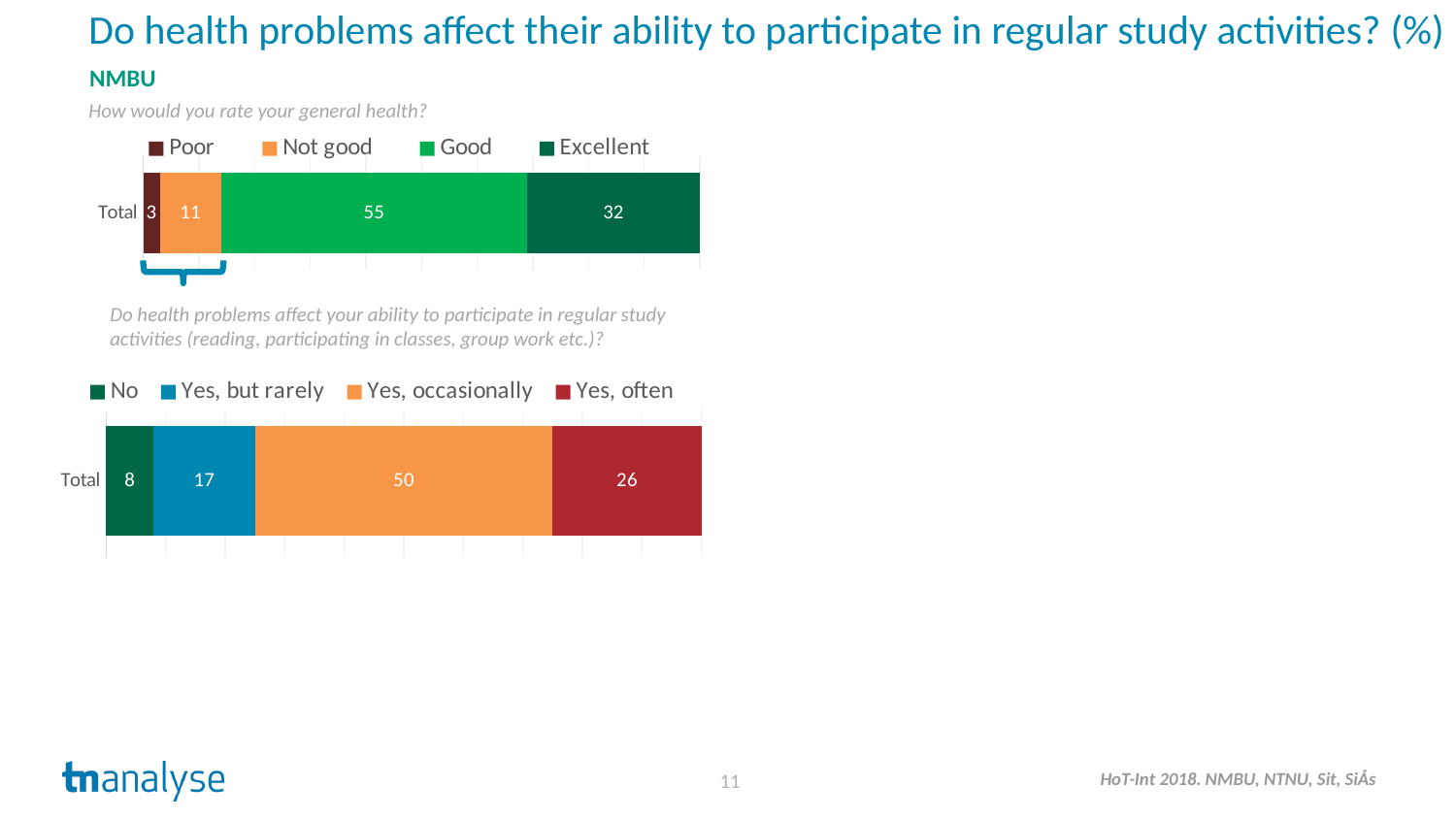
In the top chart ('How would you rate your general health?'), what is the difference between 'Good' and 'Excellent'? 23 In the bottom chart ('Do health problems affect your ability to participate in regular study activities'), which category has the lowest value? No In the top chart ('How would you rate your general health?'), what is the value for 'Poor'? 3 In the bottom chart ('Do health problems affect your ability to participate in regular study activities'), what is the value for 'Yes, often'? 26 In the bottom chart ('Do health problems affect your ability to participate in regular study activities'), which is larger: 'Yes, but rarely' or 'Yes, often'? Yes, often In the top chart ('How would you rate your general health?'), which category has the lowest value? Poor In the top chart ('How would you rate your general health?'), what is the value for 'Good'? 55 What kind of chart is the bottom chart ('Do health problems affect your ability to participate in regular study activities')? Stacked bar chart In the top chart ('How would you rate your general health?'), which category has the highest value? Good In the top chart ('How would you rate your general health?'), how many series does the legend list? 4 In the bottom chart ('Do health problems affect your ability to participate in regular study activities'), what is the total of the stacked bar? 101 In the bottom chart ('Do health problems affect your ability to participate in regular study activities'), what is the value for 'Yes, occasionally'? 50